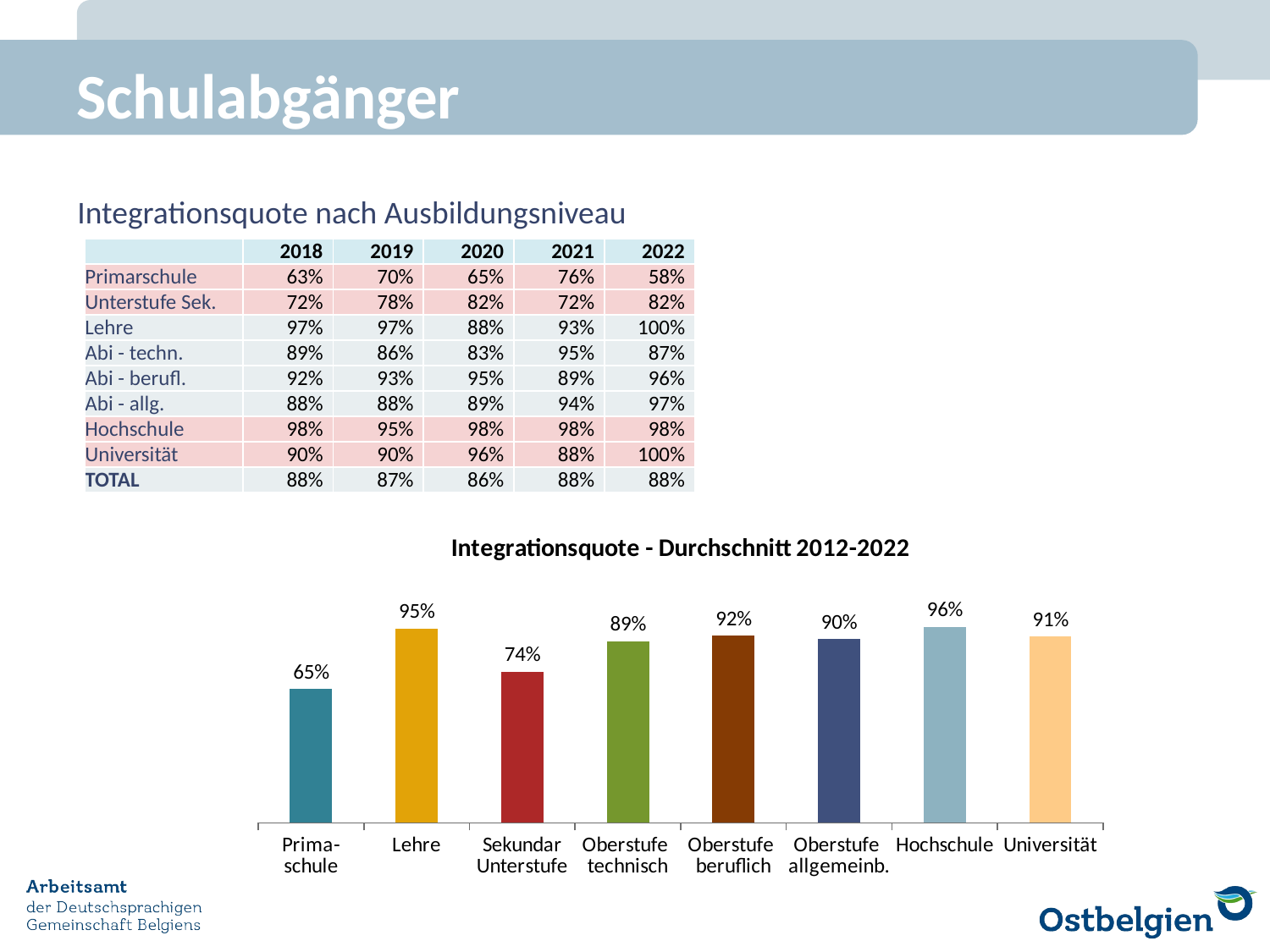
Which category has the lowest value in the chart? Primaschule How many categories are shown in the chart? 8 Which is larger in the chart: the value for Oberstufe technisch or Oberstufe allgemeinb.? Oberstufe allgemeinb. What is the difference between the values for Lehre and Sekundar Unterstufe in the chart? 21% What is the value for Lehre in the chart 'Integrationsquote - Durchschnitt 2012-2022'? 95% What is the value for Sekundar Unterstufe in the chart? 74% What kind of chart is shown on the slide? Bar chart Which category has the highest value in the chart? Hochschule What is the title of the chart on the slide? Integrationsquote - Durchschnitt 2012-2022 What is the value for Oberstufe beruflich in the chart? 92% What is the difference between the values for Hochschule and Primaschule in the chart? 31% What is the value for Universität in the chart? 91%